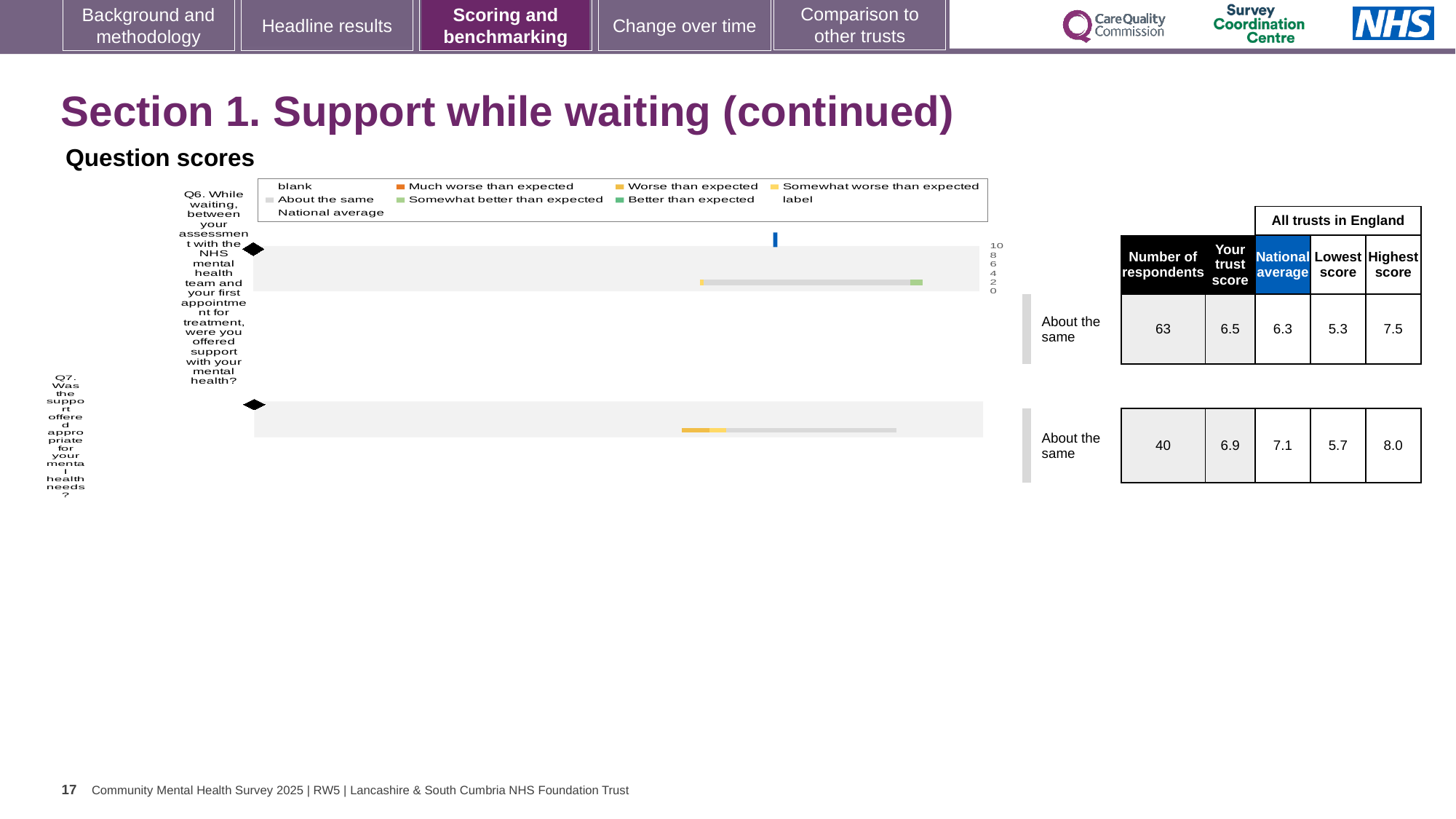
For Q6, which is larger: the trust's score or the national average? the trust's score What is the highest value shown on the chart's score axis? 10 In the table beside the chart, what is the national average for Q7? 7.1 In the table beside the chart, what is the highest score across all trusts in England for Q7? 8.0 In the table beside the chart, what is the lowest score across all trusts in England for Q6? 5.3 What benchmark category label is shown next to the bars for both Q6 and Q7? About the same In the table beside the chart, what is the trust's score for Q6? 6.5 For Q7, which is larger: the trust's score or the national average? the national average How many questions (bars) are plotted in the question scores chart? 2 What kind of chart is used to show the question scores on this slide? bar chart In the table beside the chart, what is the number of respondents for Q6? 63 What is the difference between the highest score and the lowest score for Q7 in the table beside the chart? 2.3